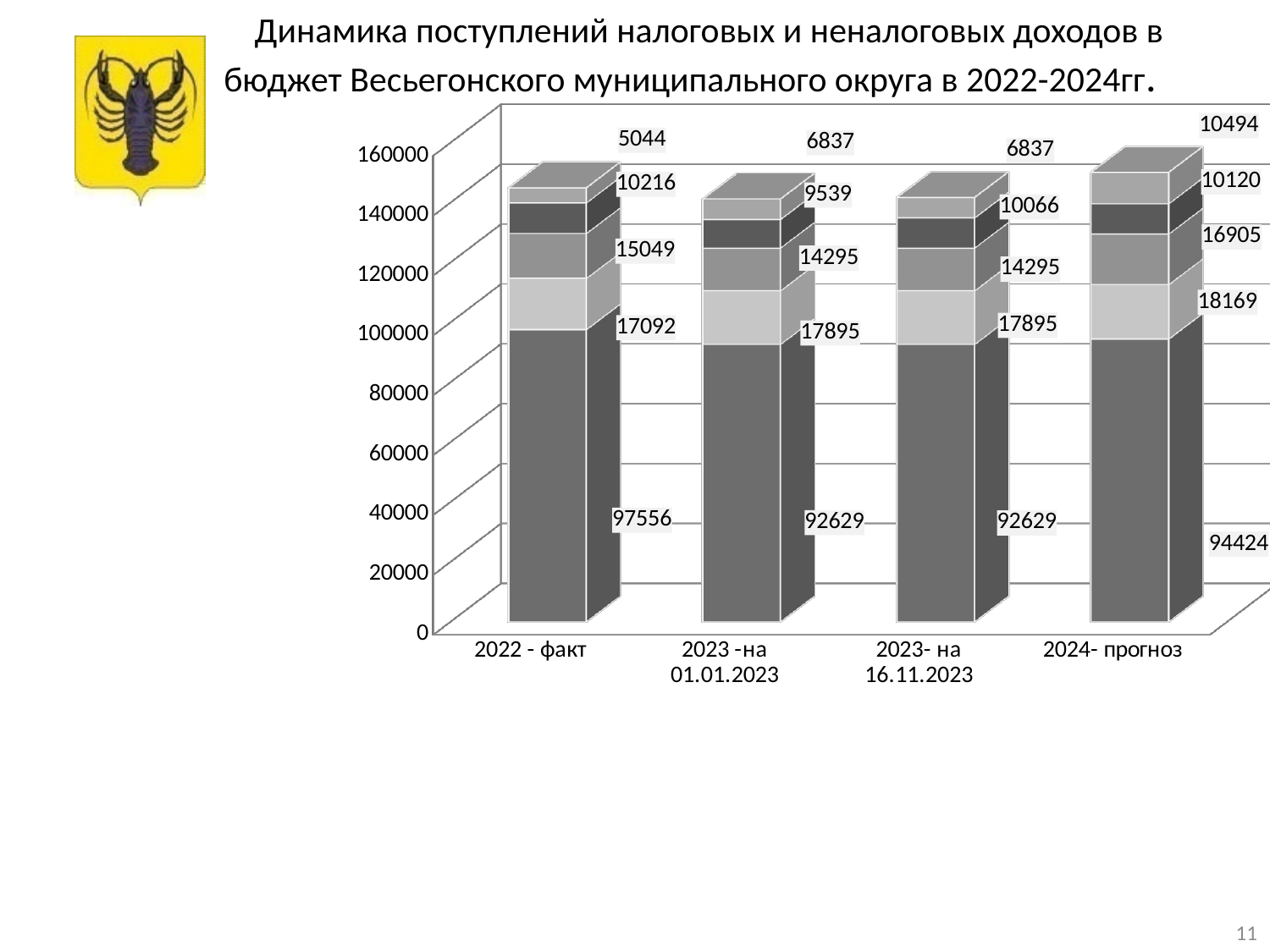
What is the value of the top segment of the bar for "2024- прогноз"? 10494 Is the total of the bar for "2023 -на 01.01.2023" greater or less than 160000? less What is the value of the second segment from the bottom of the bar for "2023- на 16.11.2023"? 17895 What is the value of the bottom (largest) segment of the bar for "2022 - факт"? 97556 What is the difference between the bottom segment values for "2022 - факт" (97556) and "2024- прогноз" (94424)? 3132 What is the total of the stacked bar for "2024- прогноз"? 150112 Which category has the highest total stacked bar? 2024- прогноз What kind of chart is shown on the slide? Stacked bar chart Which is larger: the top segment for "2022 - факт" or the top segment for "2024- прогноз"? 2024- прогноз What is the total of the stacked bar for "2022 - факт"? 144957 How many categories are shown along the x axis of the chart? 4 What is the value of the bottom segment of the bar for "2023 -на 01.01.2023"? 92629